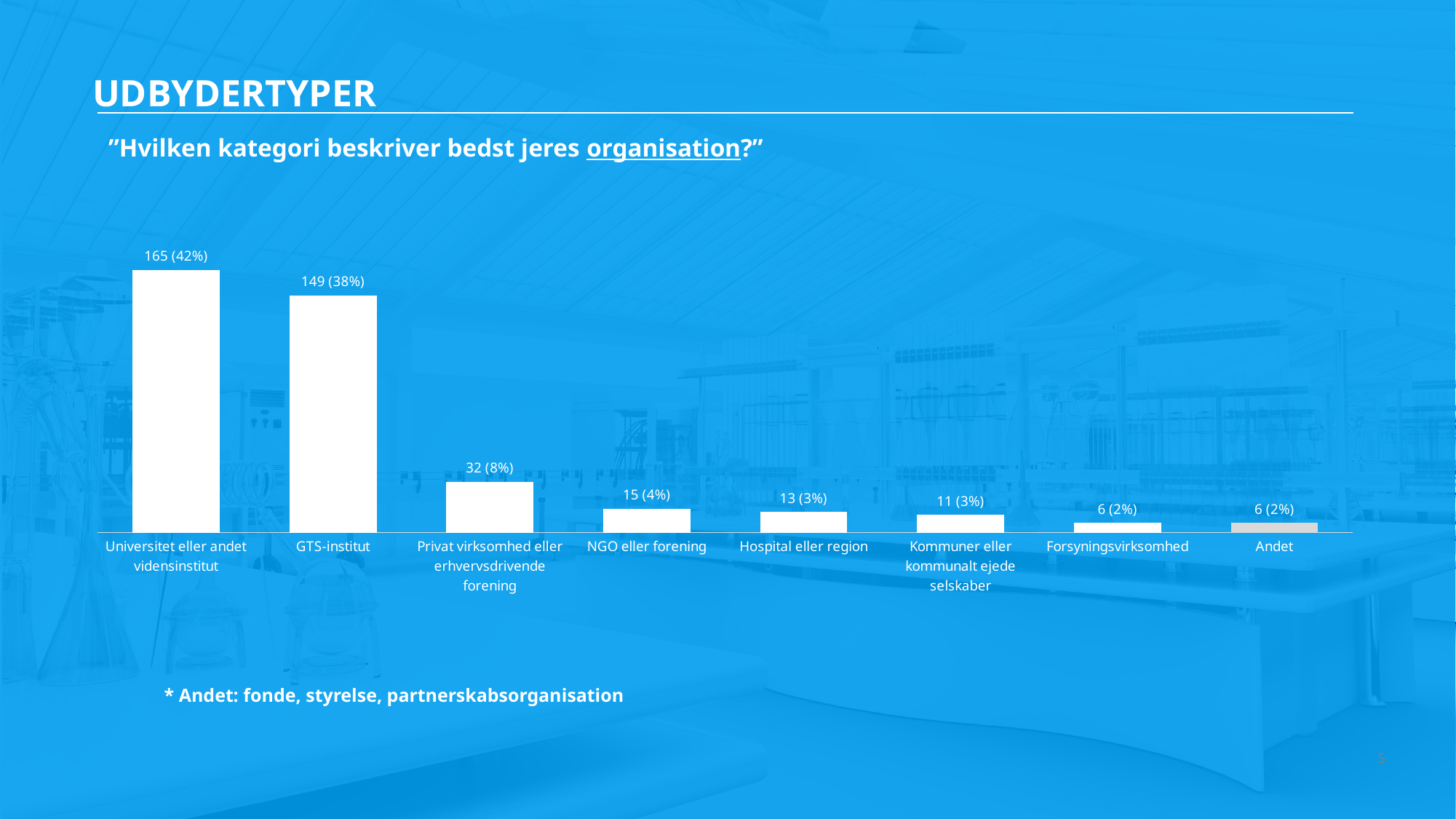
Which is larger, the value for Privat virksomhed eller erhvervsdrivende forening or the value for NGO eller forening? Privat virksomhed eller erhvervsdrivende forening What is the difference in count between Universitet eller andet vidensinstitut and GTS-institut? 16 Which bar is shown in a different colour (grey) from the others? Andet What value is shown for GTS-institut? 149 (38%) What percentage is shown for Forsyningsvirksomhed? 2% What value is shown for Privat virksomhed eller erhvervsdrivende forening? 32 (8%) How many categories are shown in the chart? 8 Do the values rise or fall from left to right across the categories? Fall Which category has the highest value? Universitet eller andet vidensinstitut What is the difference in count between NGO eller forening and Kommuner eller kommunalt ejede selskaber? 4 What value is shown for Hospital eller region? 13 (3%) What kind of chart is shown on the slide? Bar chart